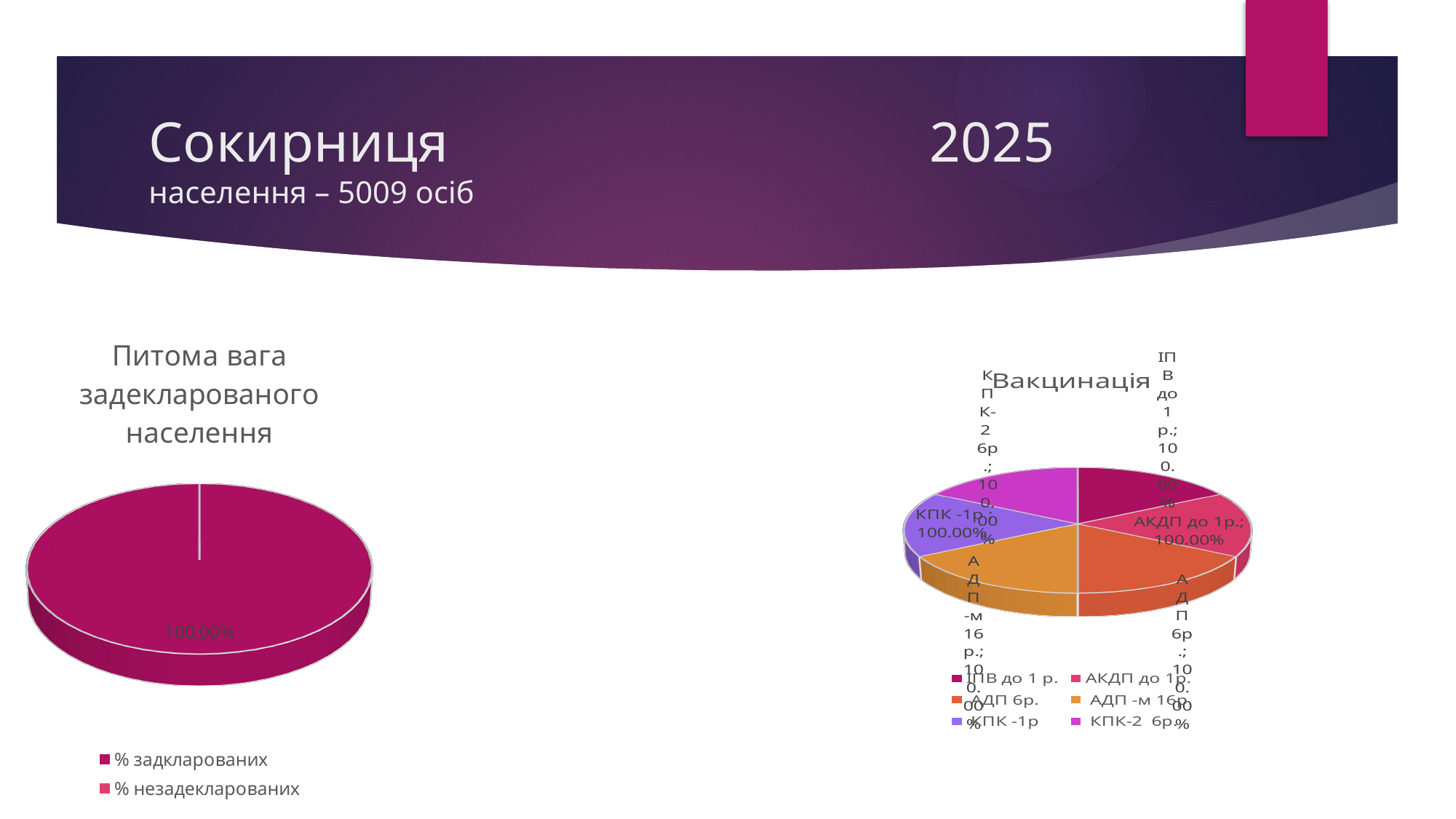
How many slices are drawn in the chart titled "Вакцинація"? 6 How many entries does the legend of the chart titled "Вакцинація" list? 6 In the chart titled "Вакцинація", what value is labelled for "ІПВ до 1 р."? 100.00% In the chart titled "Вакцинація", what value is labelled for "АКДП до 1р."? 100.00% In the chart titled "Вакцинація", what value is labelled for "КПК -1р"? 100.00% In the chart titled "Вакцинація", what value is labelled for "АДП 6р."? 100.00% What kind of chart is the chart titled "Питома вага задекларованого населення"? pie chart In the chart titled "Питома вага задекларованого населення", which legend entry is listed first? % задкларованих How many entries does the legend of the chart titled "Питома вага задекларованого населення" list? 2 What is the title of the pie chart on the right side of the slide? Вакцинація What kind of chart is the chart titled "Вакцинація"? pie chart In the chart titled "Питома вага задекларованого населення", what value is shown on the data label of the visible slice? 100.00%